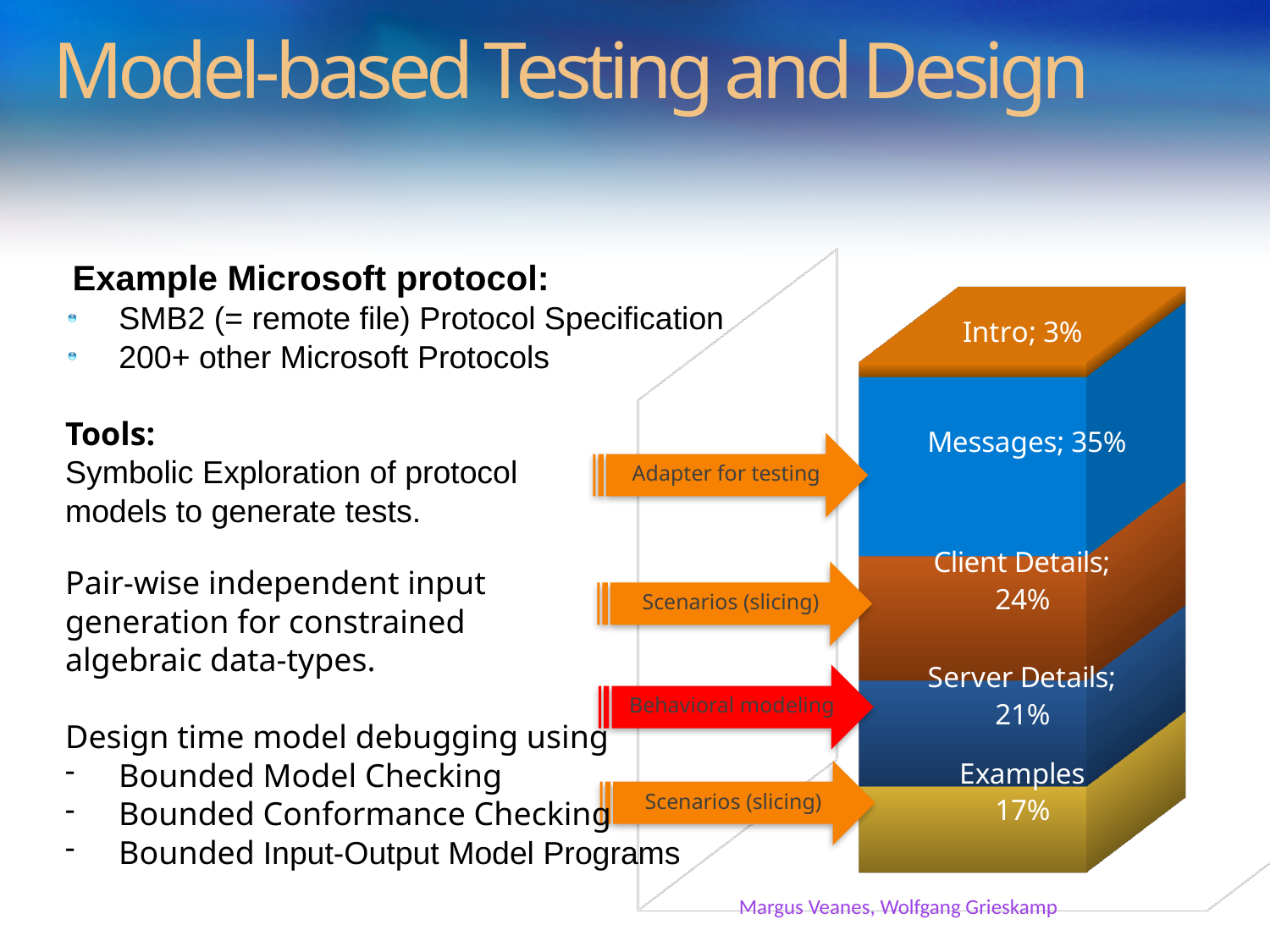
Which segment of the stacked bar has the largest percentage? Messages How many segments make up the stacked bar? 5 Which segment is larger, Client Details or Server Details? Client Details What is the difference in percentage points between the Messages and Client Details segments? 11 What percentage is shown for the Examples segment of the stacked bar? 17% What percentage is shown for the Messages segment of the stacked bar? 35% What percentage is shown for the Server Details segment of the stacked bar? 21% Which segment of the stacked bar has the smallest percentage? Intro What kind of chart is shown on the slide? Stacked bar chart What percentage is shown for the Intro segment of the stacked bar? 3% What is the difference in percentage points between the Server Details and Examples segments? 4 What is the total of all the segment percentages in the stacked bar? 100%